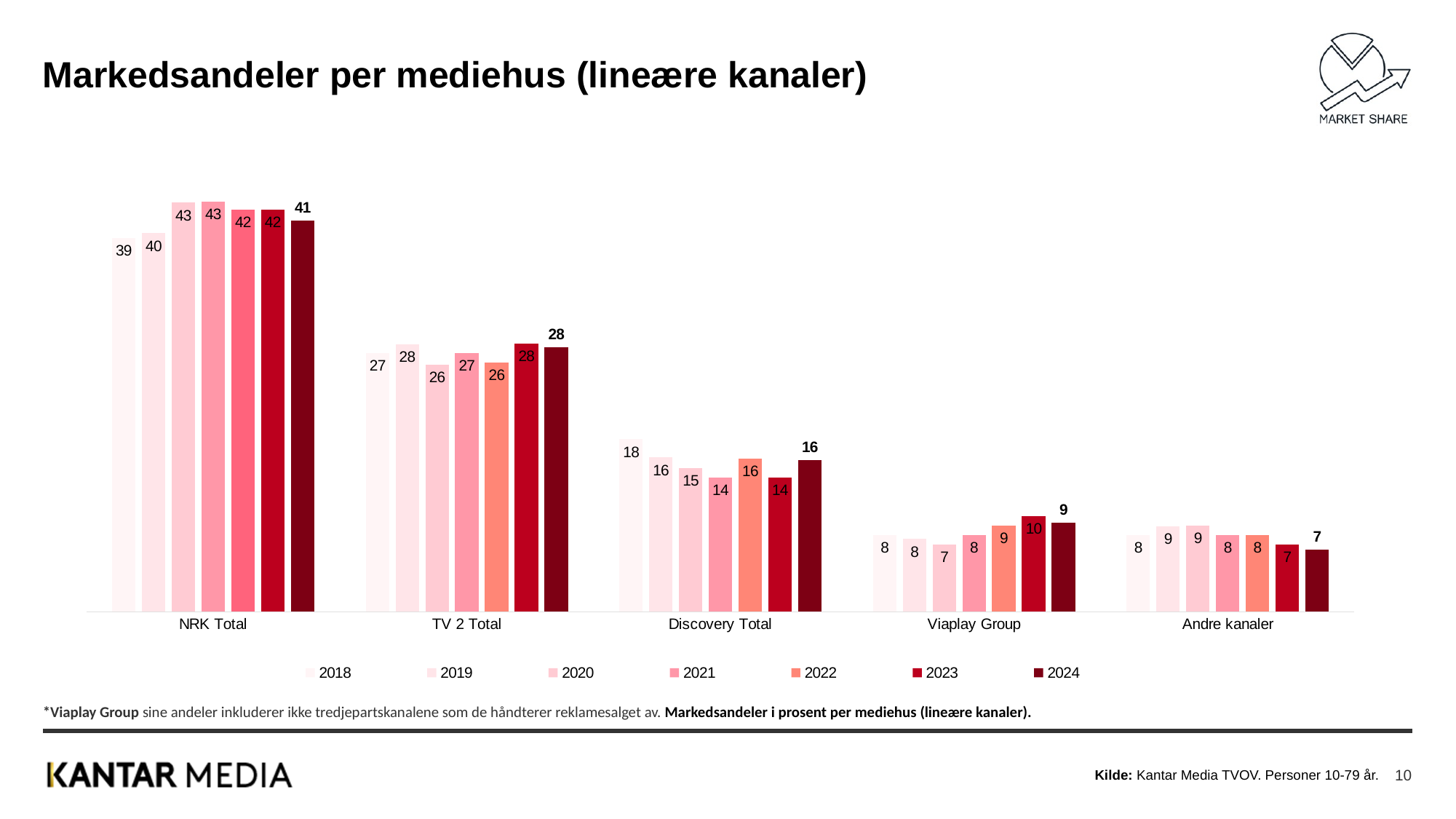
Which year has the lowest value for NRK Total? 2018 What is the value for TV 2 Total in 2020? 26 Which is larger: the 2024 value for Viaplay Group or the 2024 value for Andre kanaler? Viaplay Group Which category has the highest value in 2024? NRK Total What is the value for NRK Total in 2024? 41 How many series does the legend list? 7 What kind of chart is shown on the slide? Bar chart What is the value for Discovery Total in 2018? 18 What is the value for Viaplay Group in 2023? 10 How many categories are shown on the x axis? 5 What is the difference between the NRK Total values for 2018 and 2024? 2 What is the title of the chart? Markedsandeler per mediehus (lineære kanaler)